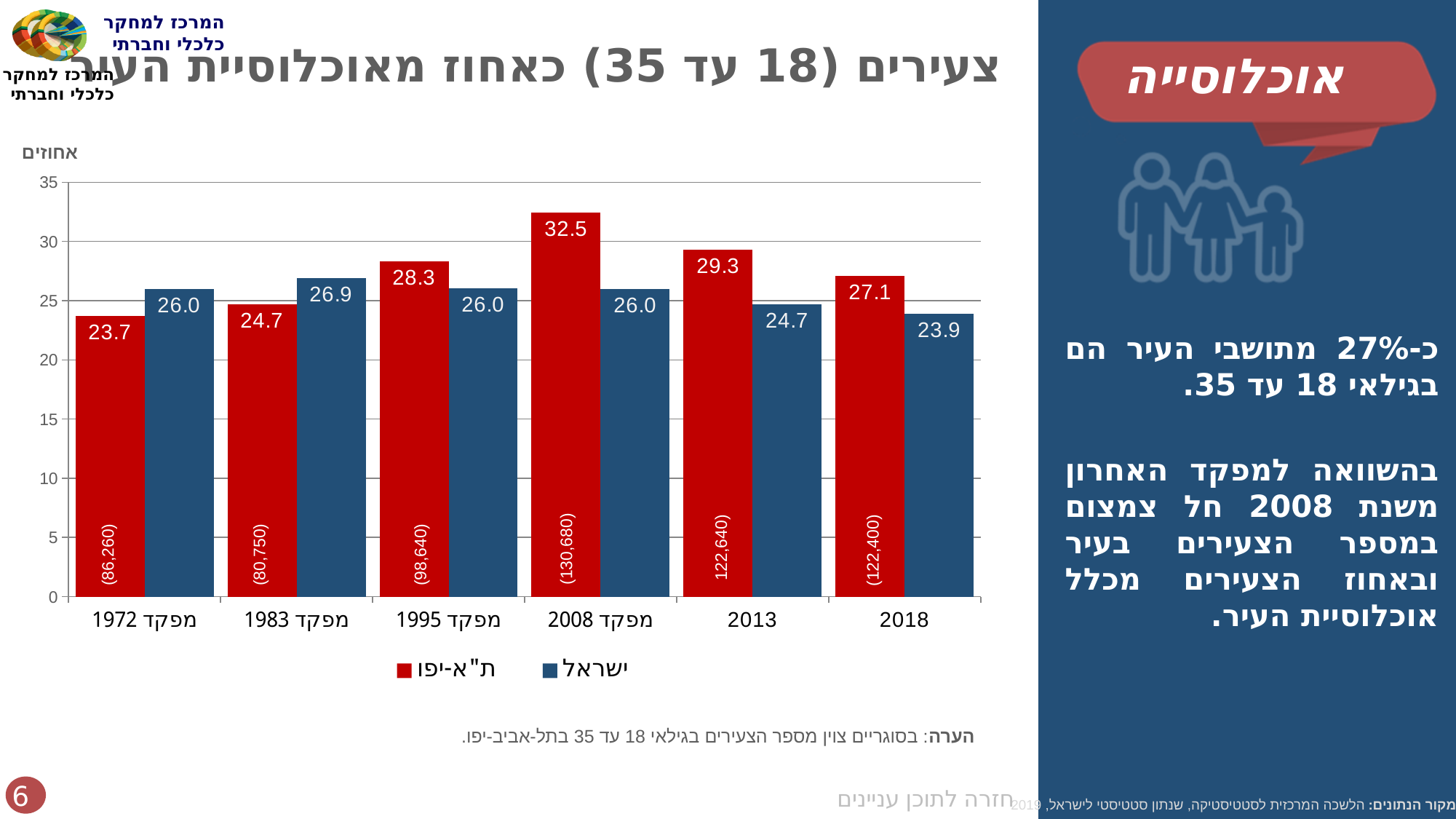
What number is printed inside the ת"א-יפו bar for מפקד 2008? (130,680) What is the difference between the ת"א-יפו and ישראל values in מפקד 2008? 6.5 In which category is the ת"א-יפו value highest? מפקד 2008 What is the value for ישראל in 2018? 23.9 What is the value for ת"א-יפו in מפקד 2008? 32.5 What is the value for ת"א-יפו in מפקד 1972? 23.7 What kind of chart is shown? bar chart How many series does the legend list? 2 Which is larger in מפקד 1983: ת"א-יפו or ישראל? ישראל In which category is the ישראל value lowest? 2018 How many categories are shown on the x axis? 6 Which colour represents ת"א-יפו in the legend? red